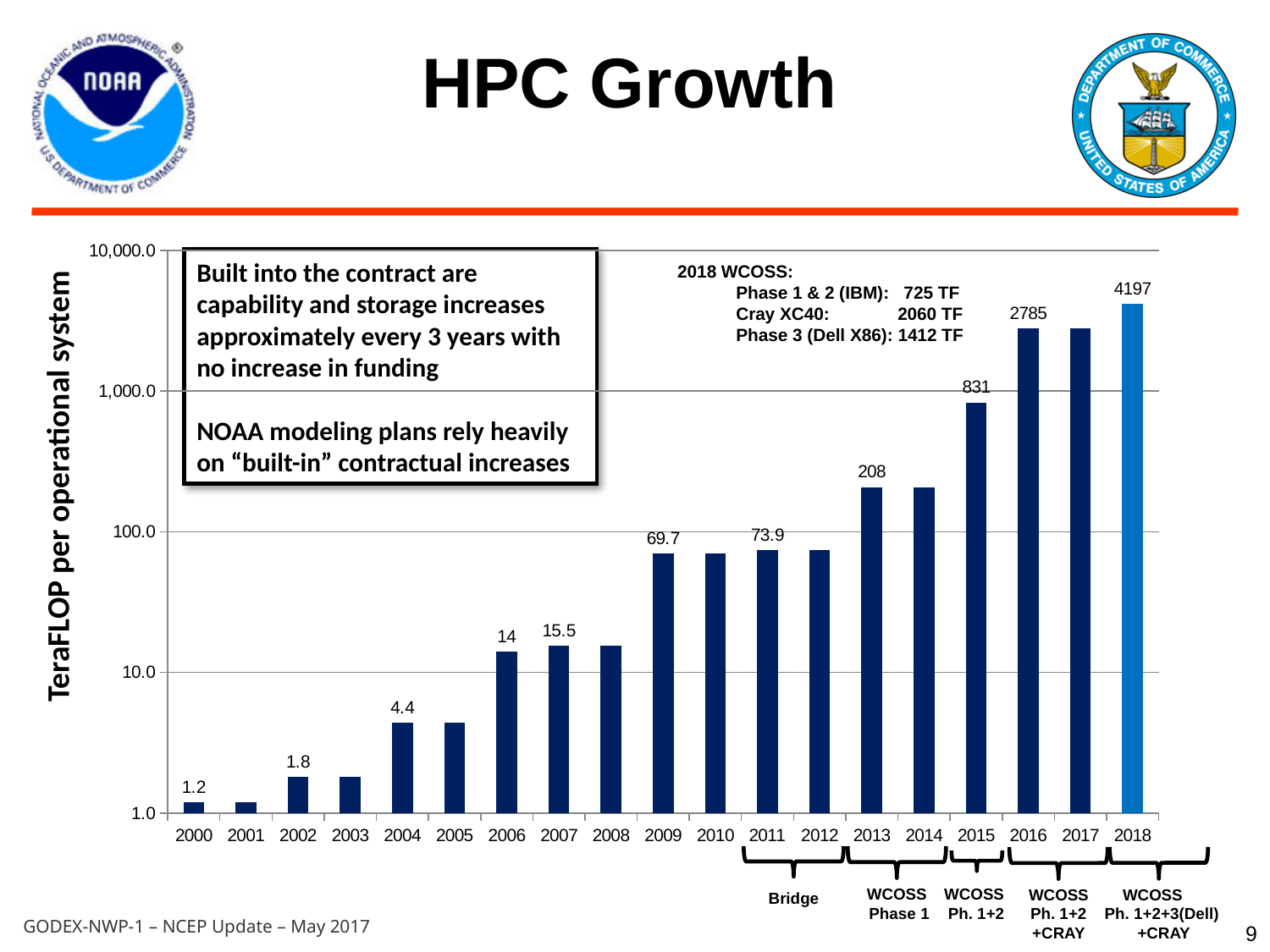
How many years are shown on the x axis? 19 What is the title of the y axis? TeraFLOP per operational system What is the value for 2004? 4.4 What is the value for 2009? 69.7 What is the value for 2018? 4197 Is the value for 2017 greater or less than 1,000.0? greater What is the difference between the values for 2018 and 2016? 1412 Is the value for 2005 greater or less than 10.0? less What is the difference between the values for 2007 and 2006? 1.5 Which is larger, the value for 2015 or the value for 2013? 2015 What kind of chart is shown? bar chart Which year has the highest value? 2018